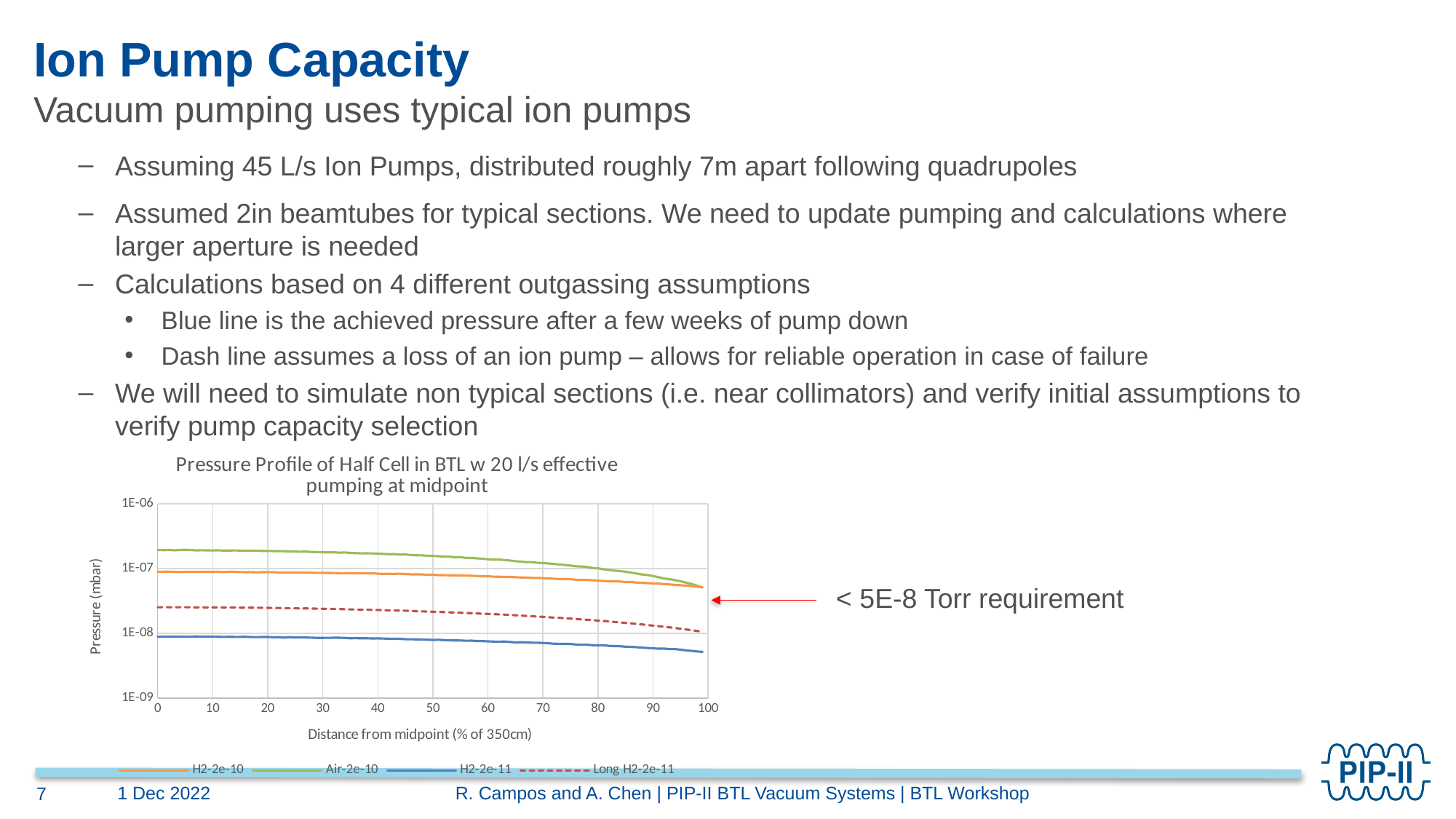
Is the pressure for the Air-2e-10 series at 100% distance greater or less than 1E-07? less Is the pressure for the H2-2e-11 series at 0% distance greater or less than 1E-08? less What is the label of the x axis of the chart? Distance from midpoint (% of 350cm) Is the pressure for the Air-2e-10 series at 0% distance greater or less than 1E-07? greater Which series has the highest pressure across the chart? Air-2e-10 What kind of chart is shown on the slide? Line chart Which series has the larger pressure at 0% distance from midpoint, H2-2e-10 or H2-2e-11? H2-2e-10 How many series does the chart legend list? 4 Which series has the lowest pressure across the chart? H2-2e-11 What is the title of the chart? Pressure Profile of Half Cell in BTL w 20 l/s effective pumping at midpoint Do the pressure values rise or fall as the distance from midpoint increases? Fall